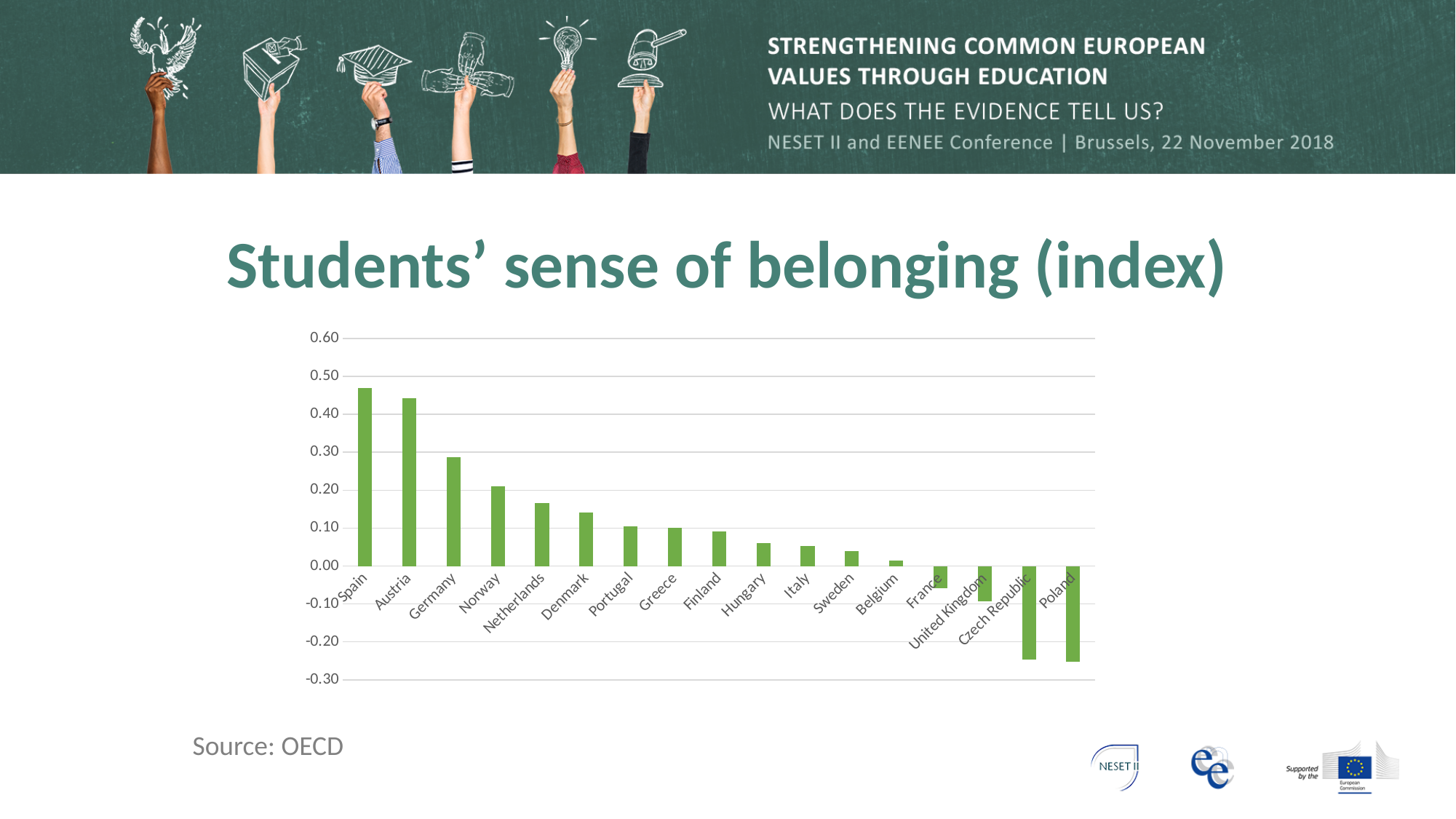
Is the value for Netherlands greater or less than 0.10? greater Do the values rise or fall moving from left to right along the x axis? Fall Which has a higher value, Sweden or Belgium? Sweden Is the value for Spain greater or less than 0.40? greater Which country has the highest sense of belonging index? Spain How many countries have a negative sense of belonging index? 4 How many countries are shown on the x axis of the chart? 17 Is the value for Hungary greater or less than 0.10? less Which has a higher value, Germany or Norway? Germany What is the title of the chart? Students' sense of belonging (index) What kind of chart is shown on the slide? Bar chart